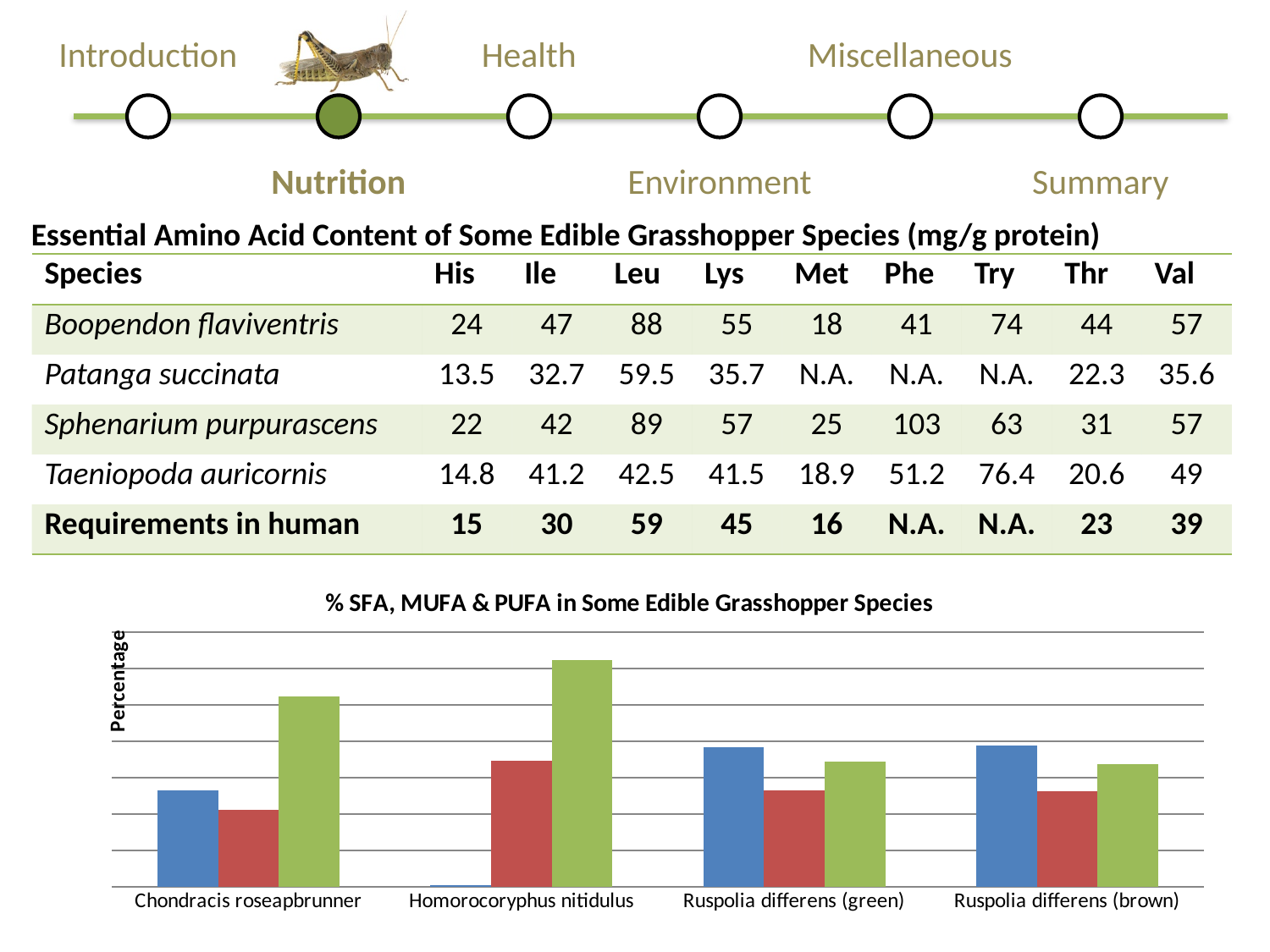
In the bar chart, for Homorocoryphus nitidulus, is the red bar or the green bar taller? green bar What is the label on the y axis of the bar chart? Percentage In the bar chart, which species has the shortest red bar? Chondracis roseapbrunner What is the title of the bar chart? % SFA, MUFA & PUFA in Some Edible Grasshopper Species In the bar chart, which species has the tallest bar overall? Homorocoryphus nitidulus In the bar chart, which species has the tallest green bar? Homorocoryphus nitidulus In the bar chart, for Chondracis roseapbrunner, is the green bar or the blue bar taller? green bar How many differently coloured bars are plotted for each species in the bar chart? 3 In the bar chart, for Ruspolia differens (green), is the blue bar or the red bar taller? blue bar What kind of chart is shown at the bottom of the slide? bar chart In the bar chart, which species has the shortest blue bar? Homorocoryphus nitidulus How many grasshopper species are shown on the x axis of the bar chart? 4